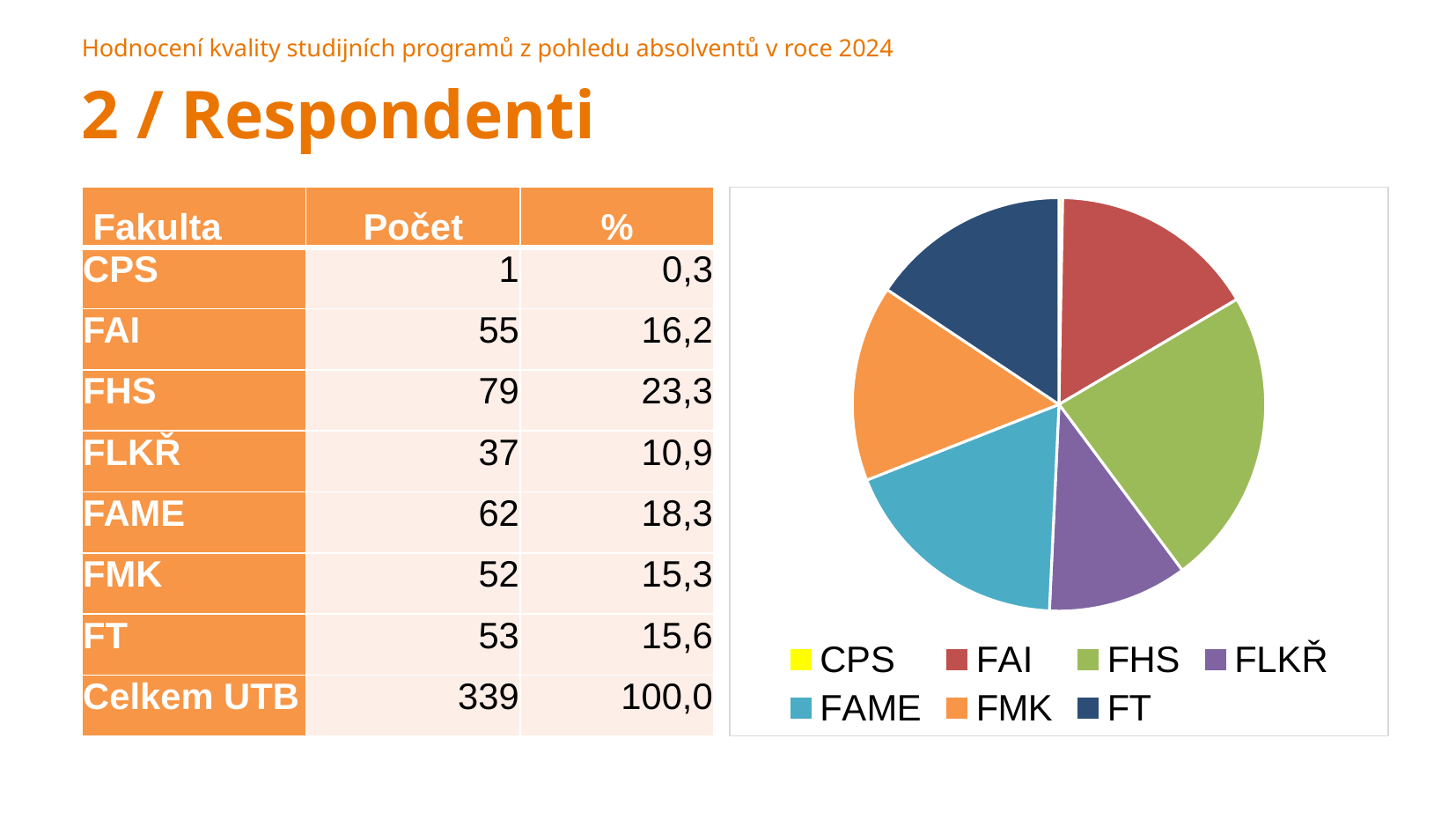
How many entries does the pie chart's legend list? 7 Which faculty is shown in dark blue in the pie chart legend? FT What is the count (Počet) for FAME shown on the slide? 62 What kind of chart is shown on the slide? pie chart What is the total number of respondents (Celkem UTB) shown on the slide? 339 In the pie chart, is the slice for FLKŘ larger or smaller than the slice for FAME? smaller What percentage share does FHS have according to the slide? 23,3 Which faculty has the largest slice in the pie chart? FHS What percentage share does FLKŘ have according to the slide? 10,9 What colour is the FHS slice in the pie chart? green Which faculty has the smallest slice in the pie chart? CPS In the pie chart, is the slice for FHS larger or smaller than the slice for FAI? larger